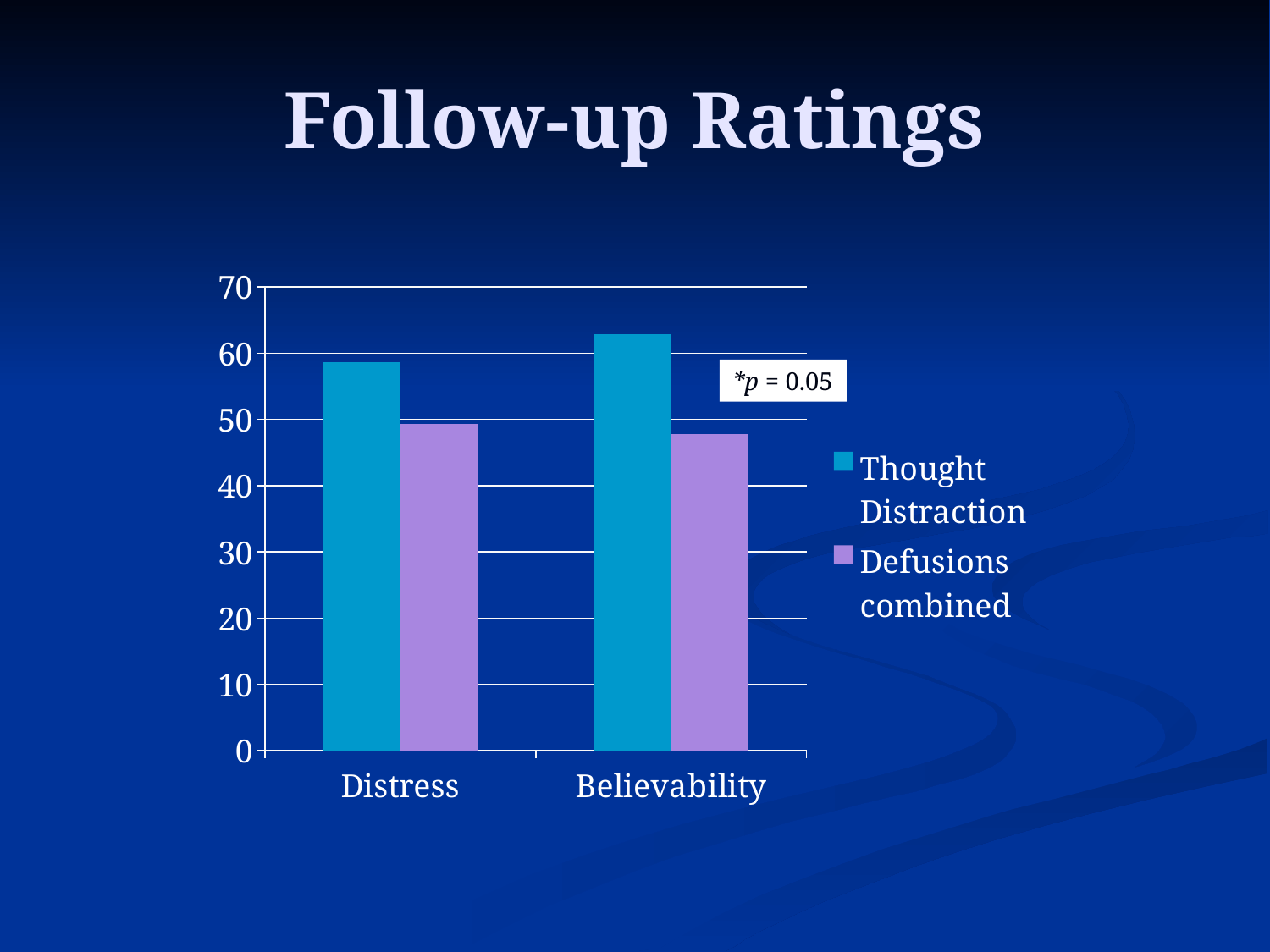
What is the title of the chart on the slide? Follow-up Ratings What kind of chart is shown on the slide? bar chart For Believability, which series has the larger value, Thought Distraction or Defusions combined? Thought Distraction For Distress, which series has the larger value, Thought Distraction or Defusions combined? Thought Distraction Which bar in the chart is the tallest? Thought Distraction for Believability Is the Thought Distraction value for Distress greater or less than 50? greater Is the Defusions combined value for Distress greater or less than 40? greater How many categories are shown on the x axis of the chart? 2 Is the Thought Distraction value for Believability greater or less than 60? greater What are the two series named in the chart's legend? Thought Distraction and Defusions combined How many series does the chart's legend list? 2